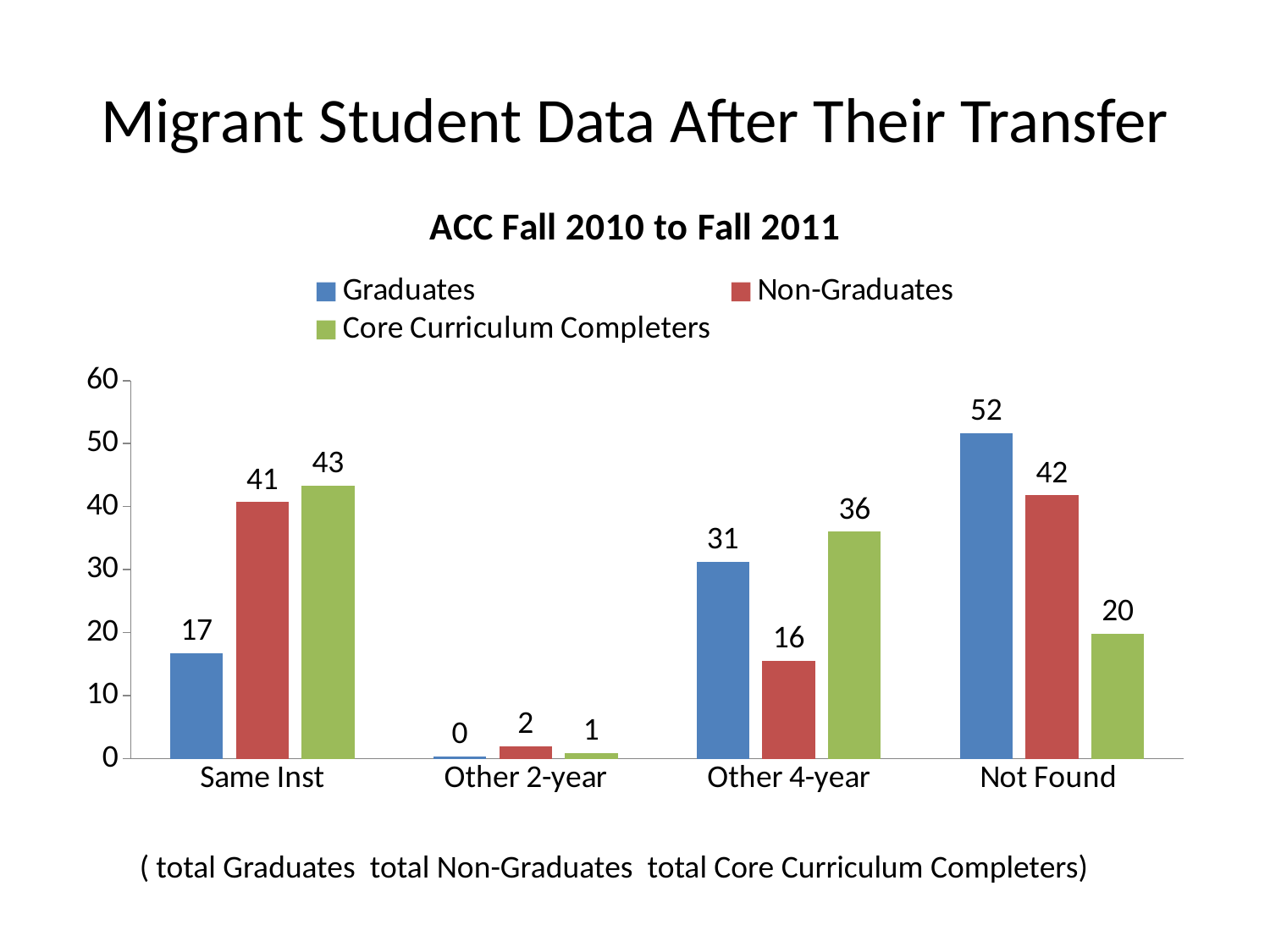
Which category has the highest value for Graduates? Not Found What kind of chart is shown on the slide? bar chart What is the difference between the Core Curriculum Completers and Graduates values in the Same Inst category? 26 What is the value for Non-Graduates in the Not Found category? 42 Is the value for Graduates in the Not Found category greater or less than 50? greater Which is larger in the Other 4-year category: Graduates or Non-Graduates? Graduates Which category has the lowest value for Core Curriculum Completers? Other 2-year What is the value for Graduates in the Same Inst category? 17 How many series does the legend list? 3 What is the title of the chart? ACC Fall 2010 to Fall 2011 What is the value for Core Curriculum Completers in the Other 4-year category? 36 How many categories are shown on the x axis? 4